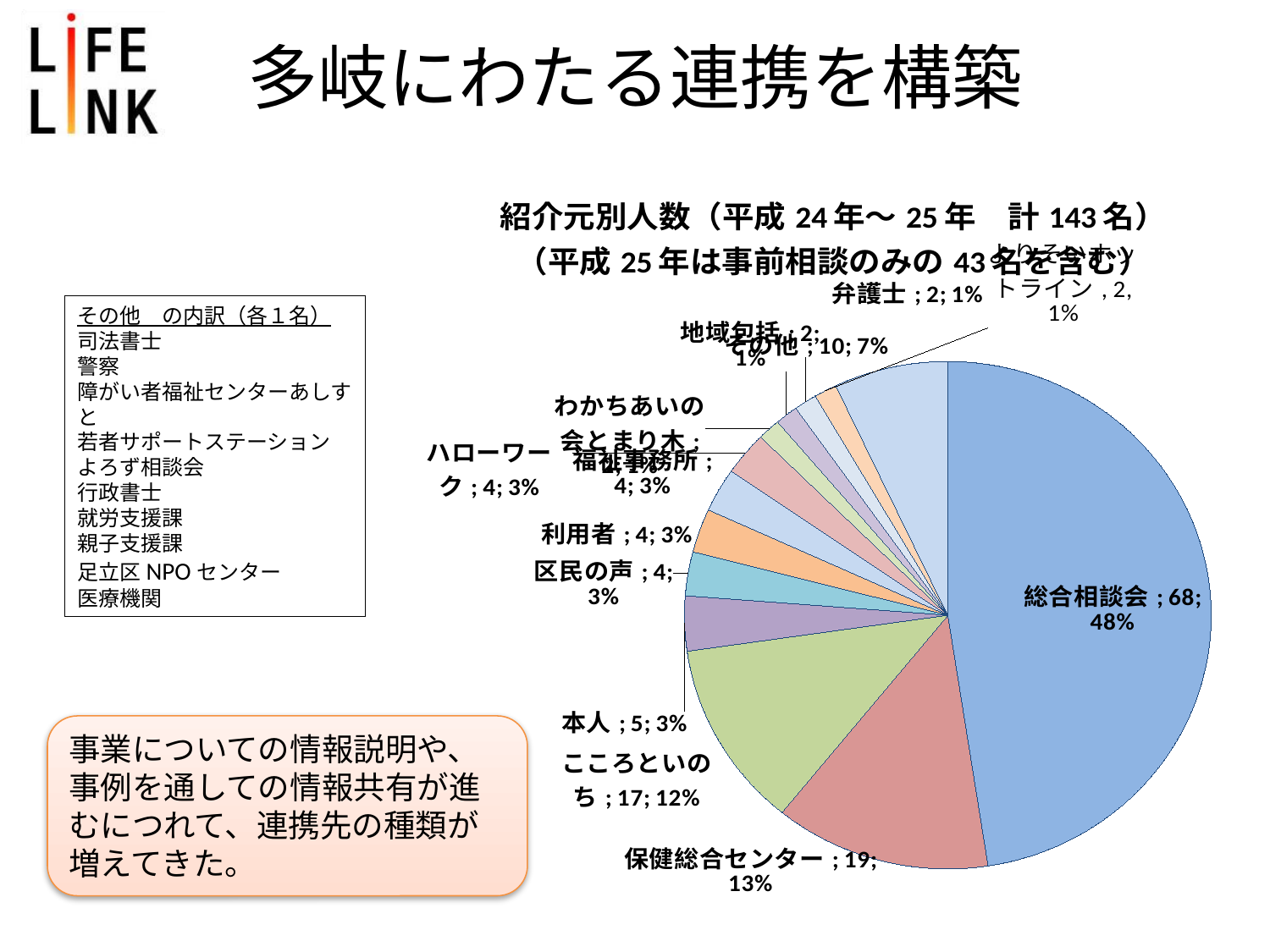
What percentage of the pie is こころといのち? 12% How many people are in the その他 category? 10 Which category has the largest slice of the pie? 総合相談会 What total number of people does the chart title state for 平成24年～25年? 143名 What is the difference in number of people between 保健総合センター and こころといのち? 2 Which is larger, the value for 本人 or the value for 区民の声? 本人 What share of the pie does 総合相談会 represent? 48% How many people came from 総合相談会 according to the pie chart? 68 How many people came from 保健総合センター? 19 What percentage of the pie is 弁護士? 1% What kind of chart is shown on the slide? pie chart What is the difference in number of people between 総合相談会 and 保健総合センター? 49